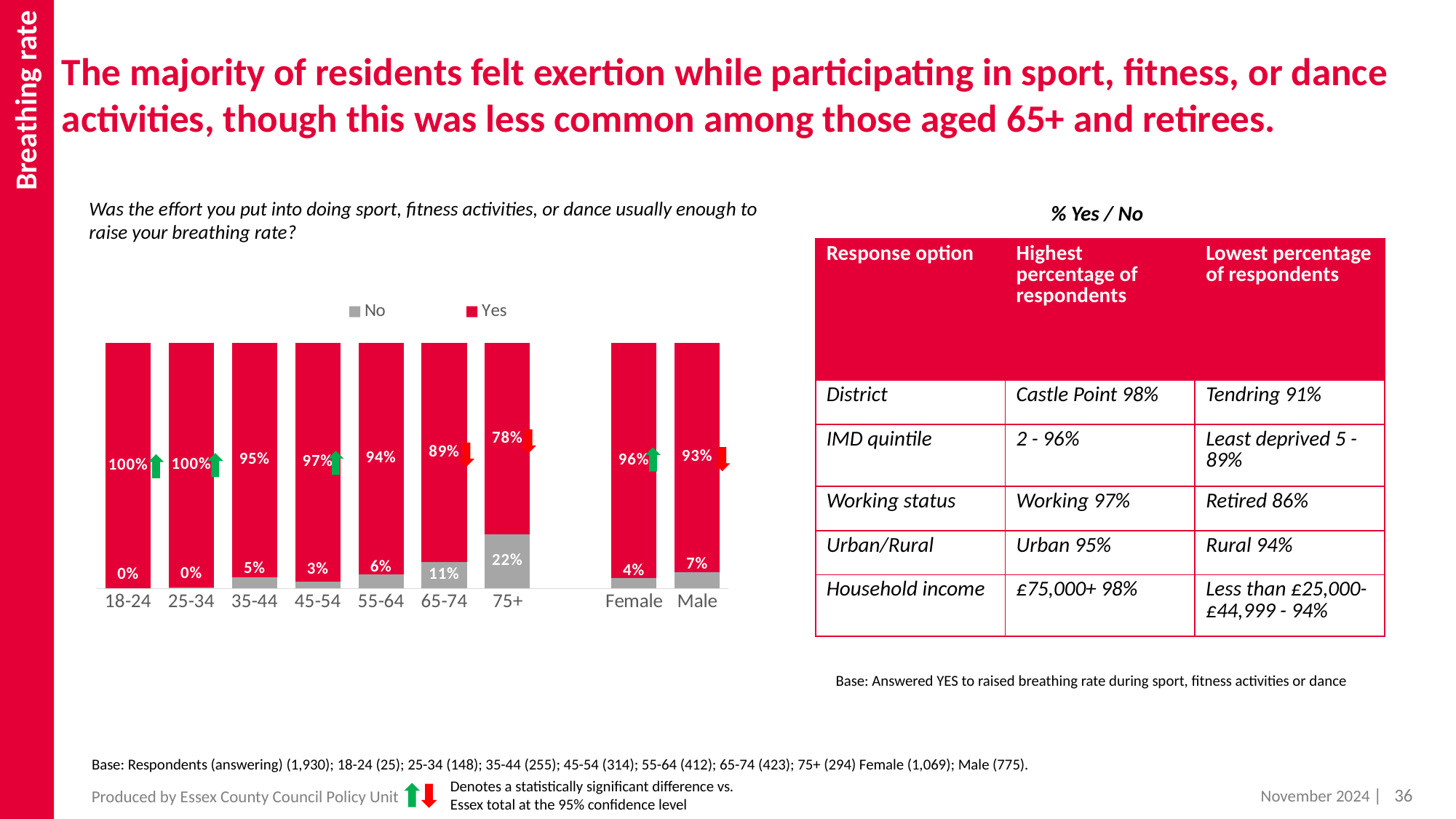
How many categories are shown on the x axis of the chart? 9 What percentage of Male respondents answered No? 7% Which has a higher Yes percentage, Female or Male? Female What percentage of 75+ respondents answered Yes? 78% How many series does the legend list? 2 Which age group has the highest No percentage? 75+ What is the difference in Yes percentage between the 35-44 and 75+ age groups? 17% What percentage of 65-74 respondents answered No? 11% Which age group has the lowest Yes percentage? 75+ What percentage of Female respondents answered Yes? 96% What colour represents the Yes series in the chart? Red What kind of chart is shown on the slide? Stacked bar chart